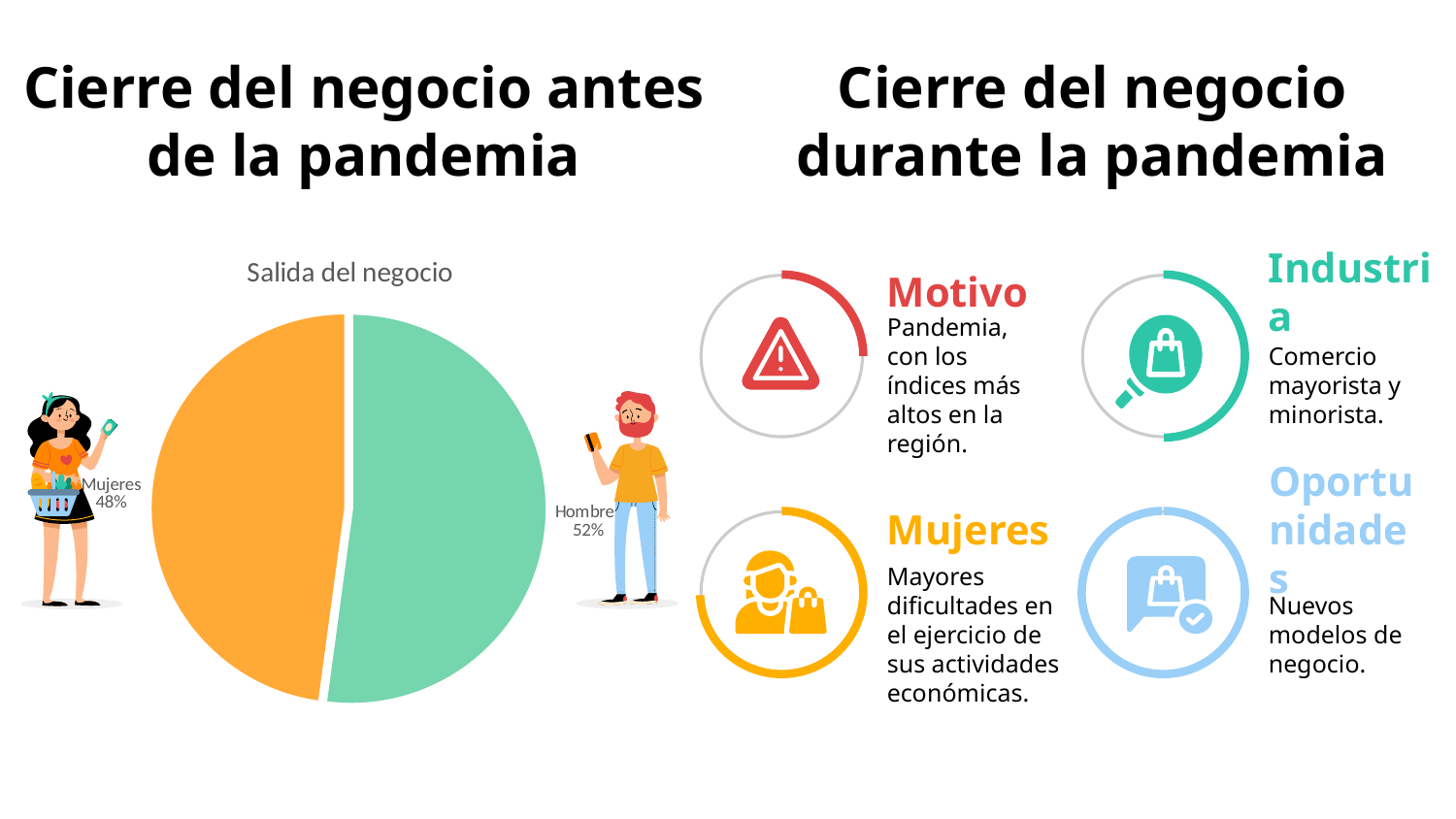
What percentage of the pie chart is labelled Mujeres? 48% How many slices does the pie chart have? 2 What is the title of the pie chart? Salida del negocio What percentage of the pie chart is labelled Hombres? 52% What type of chart is shown on the slide? pie chart What is the difference in percentage points between the Hombres and Mujeres slices? 4 Which slice of the pie chart is the largest? Hombres Which slice of the pie chart is the smallest? Mujeres What is the combined percentage of the Mujeres and Hombres slices? 100% What colour is the Mujeres slice of the pie chart? orange Is the Mujeres slice larger or smaller than the Hombres slice? smaller